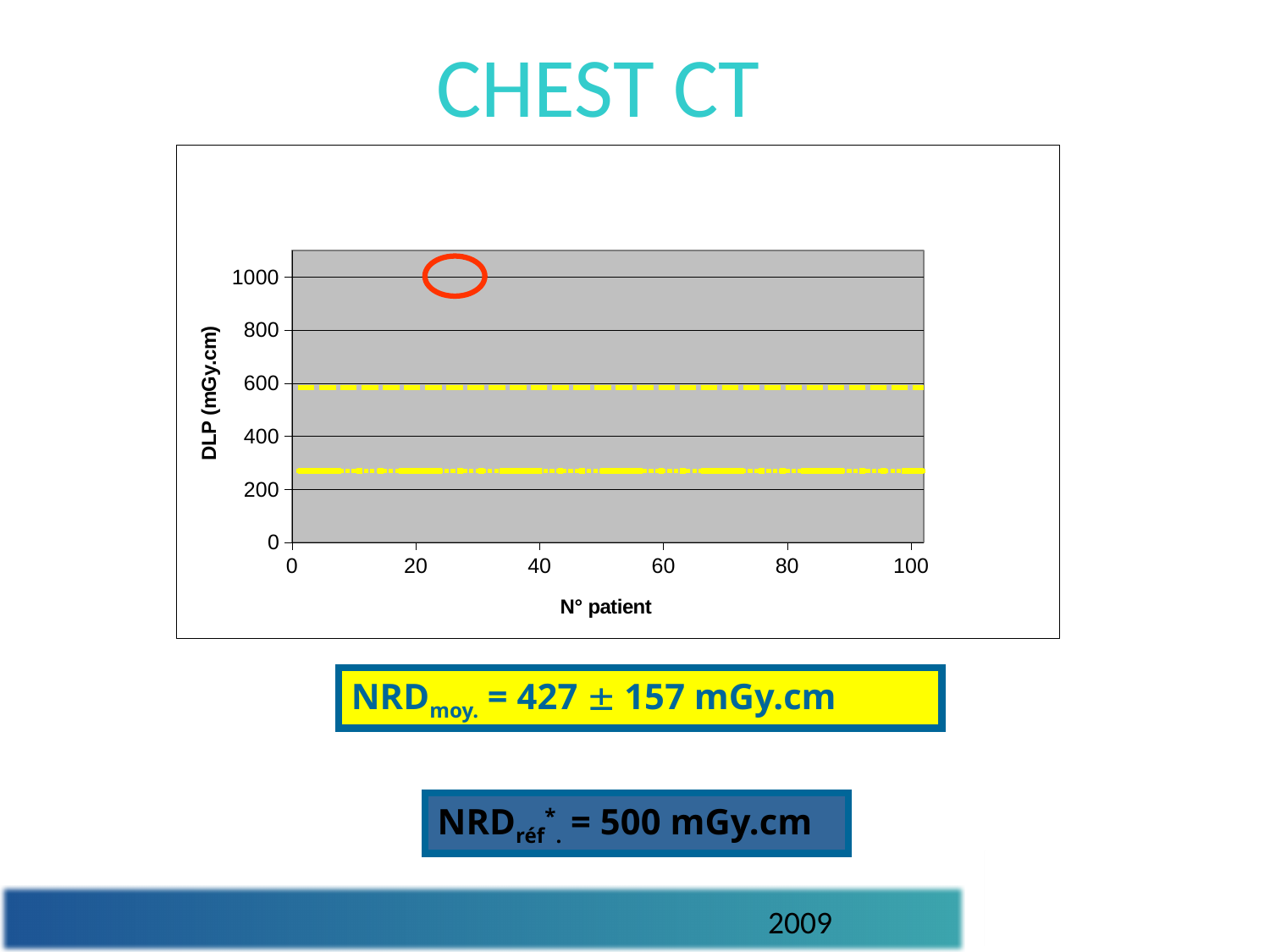
Is the upper yellow dashed line on the chart greater or less than 400 mGy.cm? greater What is the highest value shown on the vertical axis of the chart? 1000 What is the highest value shown on the horizontal axis of the chart? 100 What is the label on the horizontal axis of the chart? N° patient Is the lower yellow dashed line on the chart greater or less than 400 mGy.cm? less What is the interval between consecutive tick marks on the vertical axis of the chart? 200 Near which vertical-axis value is the red circle drawn on the chart? 1000 Is the lower yellow dashed line on the chart greater or less than 200 mGy.cm? greater Which of the two yellow dashed lines on the chart is higher, the upper one near 600 or the lower one near 300? the upper one near 600 What is the label on the vertical axis of the chart? DLP (mGy.cm) What is the interval between consecutive tick marks on the horizontal axis of the chart? 20